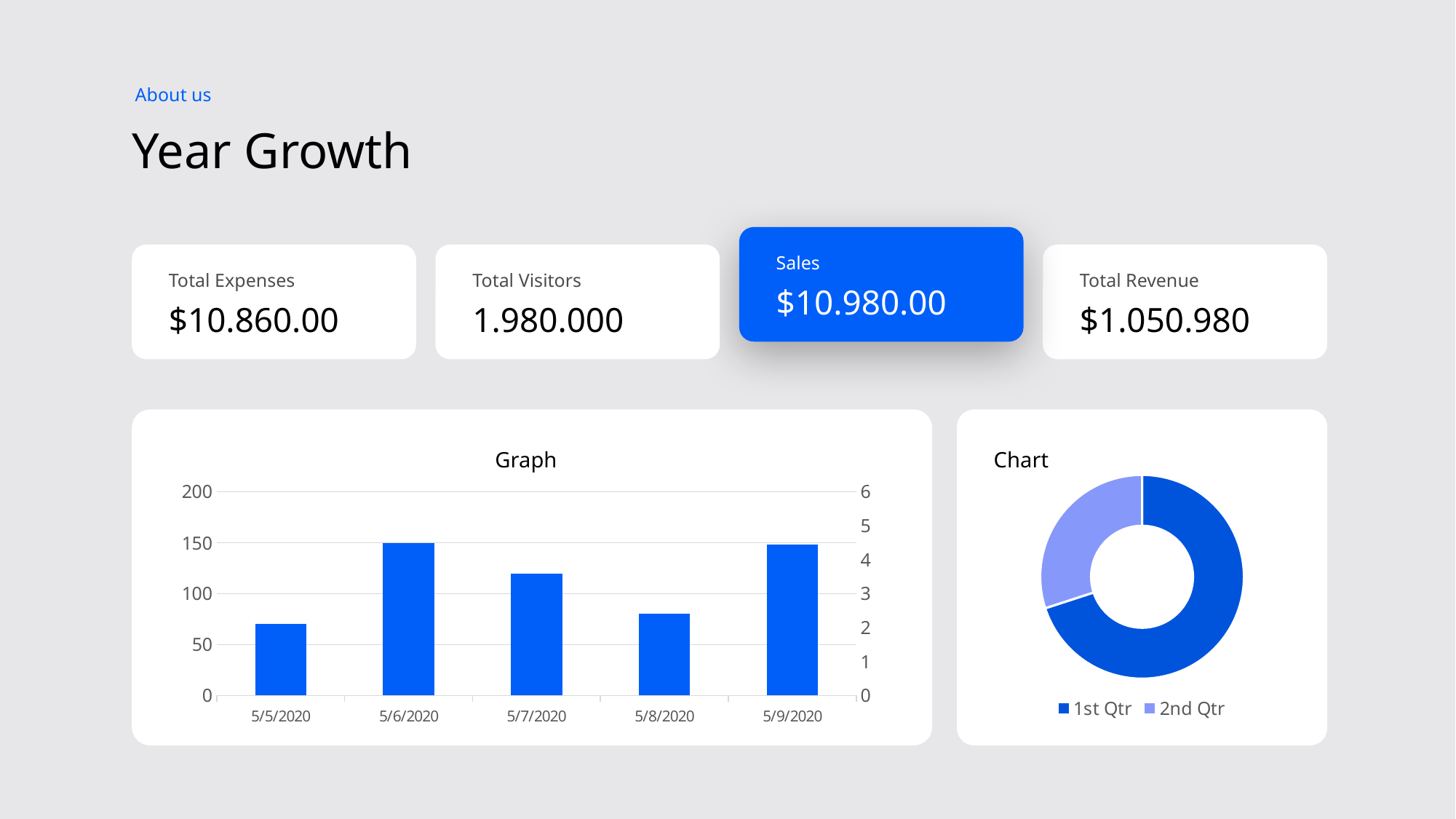
In the chart titled "Chart", how many entries does the legend list? 2 In the chart titled "Graph", which date has the lowest bar? 5/5/2020 In the chart titled "Graph", which is larger, the value for 5/6/2020 or the value for 5/8/2020? 5/6/2020 What kind of chart is the chart titled "Graph"? bar chart In the chart titled "Chart", which slice is larger, 1st Qtr or 2nd Qtr? 1st Qtr In the chart titled "Graph", is the value for 5/7/2020 greater or less than 150? less What kind of chart is the chart titled "Chart"? doughnut chart In the chart titled "Graph", how many dates are shown on the x axis? 5 In the chart titled "Graph", is the value for 5/8/2020 greater or less than 100? less In the chart titled "Graph", is the value for 5/5/2020 greater or less than 100? less In the chart titled "Graph", what is the highest tick on the left vertical axis? 200